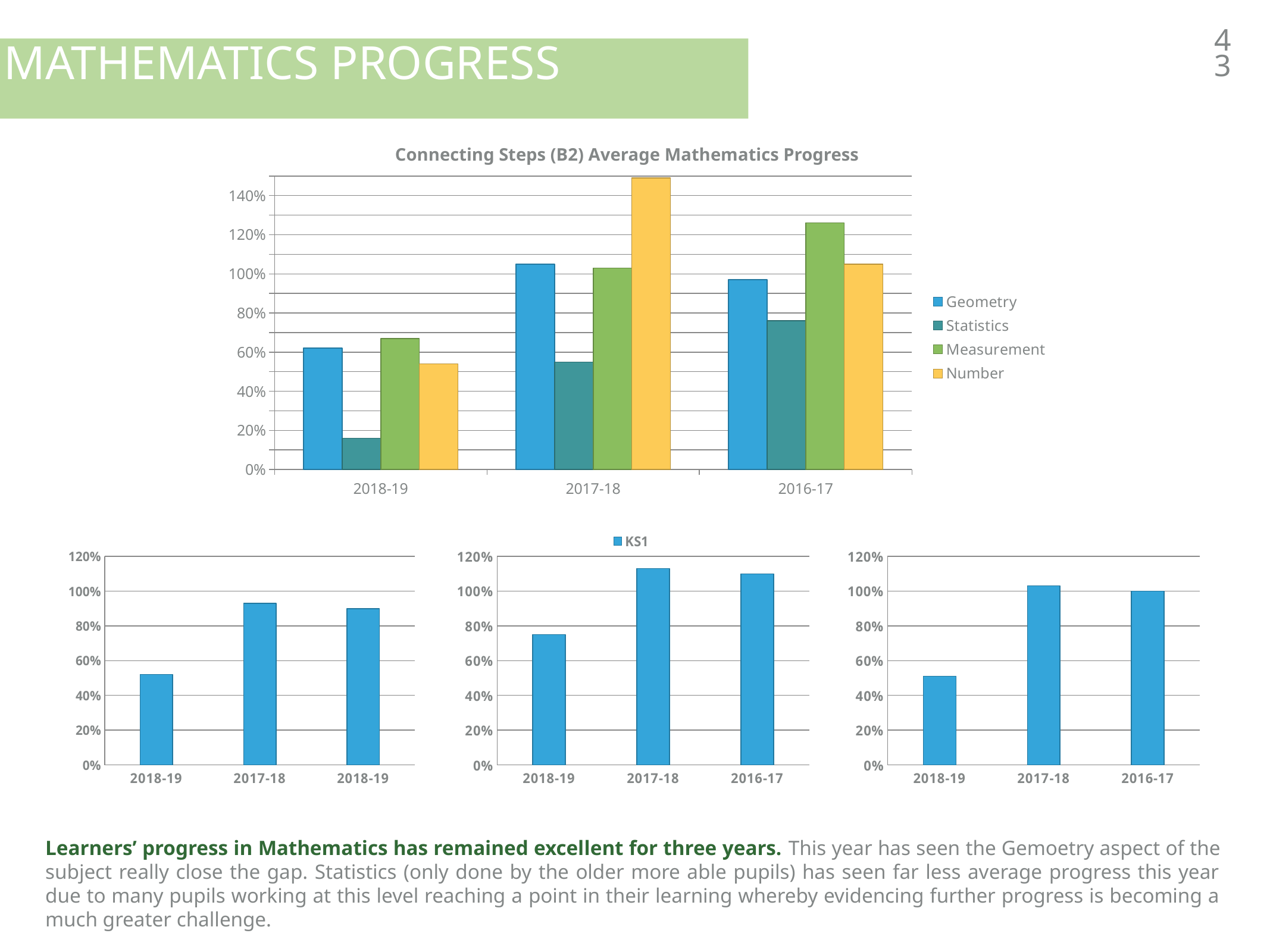
In the 'Connecting Steps (B2) Average Mathematics Progress' chart, which series has the lowest value for 2018-19? Statistics In the 'Connecting Steps (B2) Average Mathematics Progress' chart, which is larger for 2016-17: Geometry or Statistics? Geometry In the 'Connecting Steps (B2) Average Mathematics Progress' chart, is the Statistics value for 2018-19 greater or less than 20%? less How many year categories are shown on the x axis of the 'Connecting Steps (B2) Average Mathematics Progress' chart? 3 What series name is shown in the legend of the bottom-middle chart? KS1 In the bottom-middle chart (KS1), which year has the lowest value? 2018-19 In the 'Connecting Steps (B2) Average Mathematics Progress' chart, which series has the highest value for 2017-18? Number In the bottom-right chart, is the value for 2018-19 greater or less than 60%? less In the 'Connecting Steps (B2) Average Mathematics Progress' chart, is the Number value for 2017-18 greater or less than 140%? greater What kind of chart is the 'Connecting Steps (B2) Average Mathematics Progress' chart? bar chart How many series does the legend of the 'Connecting Steps (B2) Average Mathematics Progress' chart list? 4